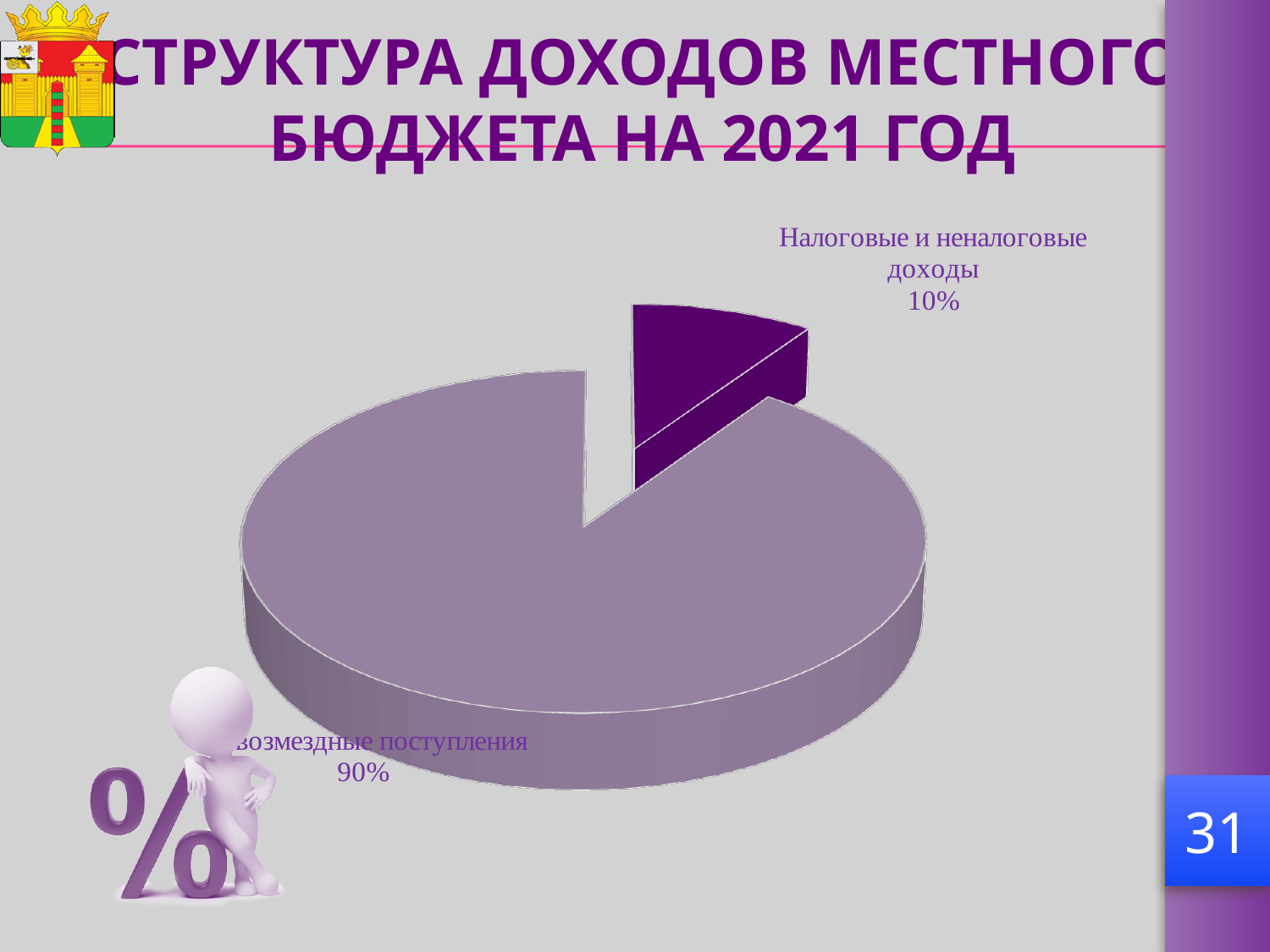
By how many percentage points does "Безвозмездные поступления" exceed "Налоговые и неналоговые доходы"? 80 percentage points What do the two slice percentages add up to? 100% What colour is the slice for "Налоговые и неналоговые доходы"? Dark purple How many slices does the pie chart have? 2 What kind of chart is shown on the slide? Pie chart What is the title of the slide containing the pie chart? СТРУКТУРА ДОХОДОВ МЕСТНОГО БЮДЖЕТА НА 2021 ГОД Which slice of the pie is the smallest? Налоговые и неналоговые доходы Which slice of the pie is the largest? Безвозмездные поступления What share of the pie is labelled "Безвозмездные поступления"? 90% Which is larger: the share for "Налоговые и неналоговые доходы" or the share for "Безвозмездные поступления"? Безвозмездные поступления What share of the pie is labelled "Налоговые и неналоговые доходы"? 10%